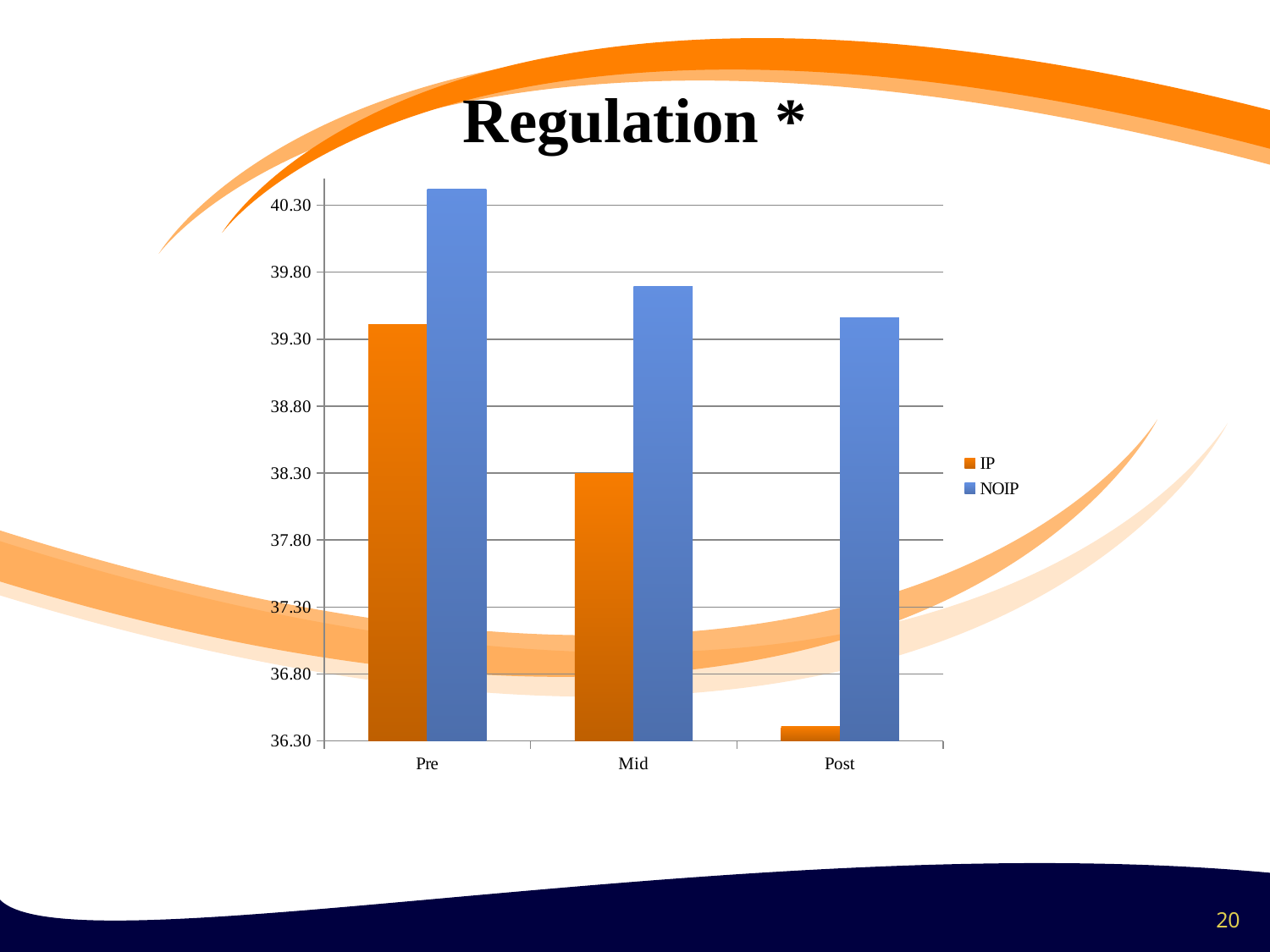
Which category has the highest NOIP value? Pre Is the NOIP value for Pre greater or less than 40.30? greater Is the IP value for Post greater or less than 36.80? less How many series does the legend list? 2 Which category has the highest IP value? Pre Do the IP values rise or fall from Pre to Post? fall What are the two entries in the legend? IP and NOIP What kind of chart is shown on the slide? bar chart For the Pre category, which series has the larger value, IP or NOIP? NOIP Which category has the lowest NOIP value? Post Which category has the lowest IP value? Post How many categories are shown on the x axis? 3